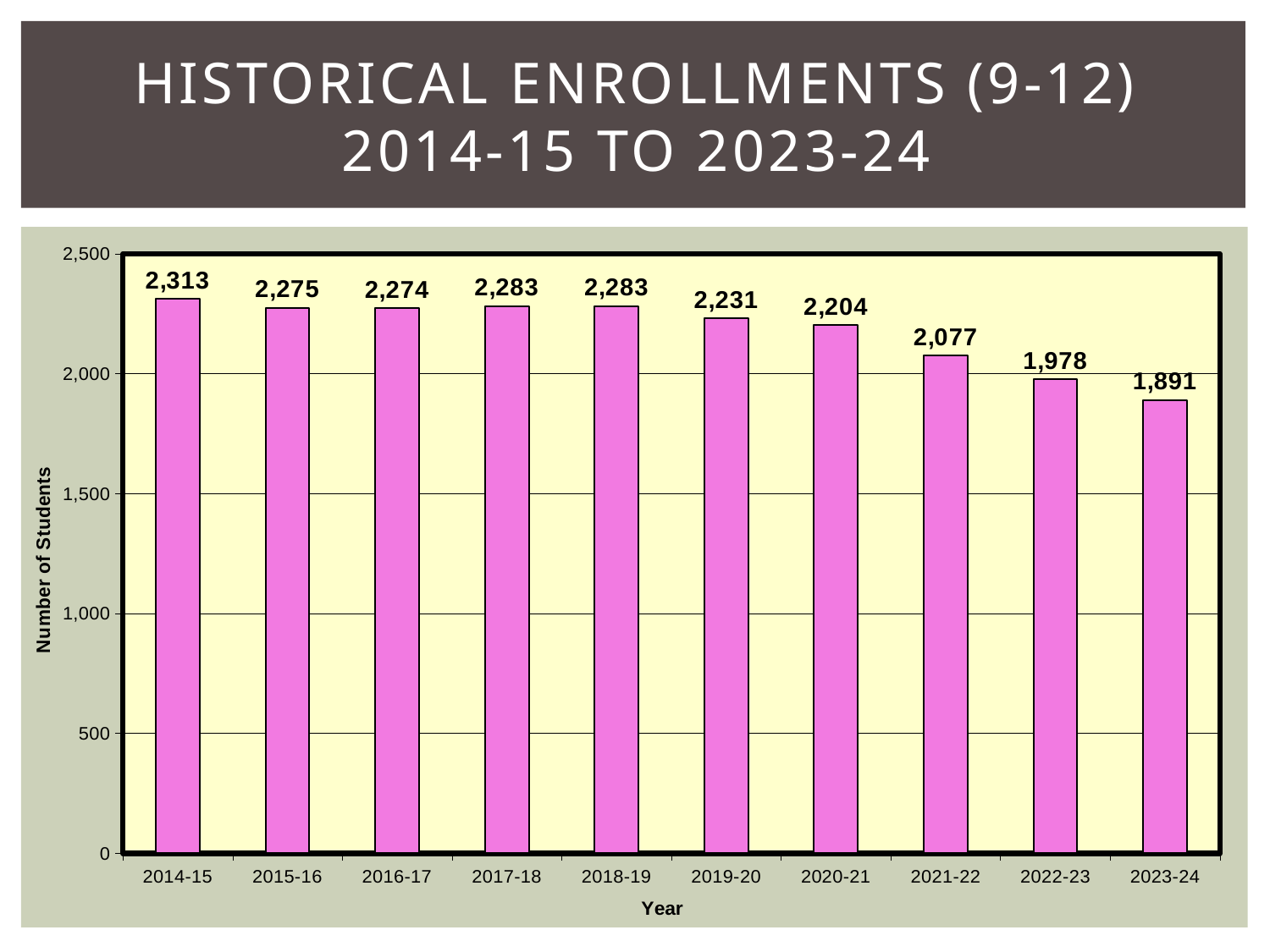
Which year has the larger enrollment, 2019-20 or 2022-23? 2019-20 Which year has the lowest enrollment? 2023-24 What is the number of students for 2014-15? 2,313 Do enrollments generally rise or fall from 2014-15 to 2023-24? fall What is the number of students for 2023-24? 1,891 What kind of chart is shown on the slide? bar chart How many years are shown on the chart? 10 What is the number of students for 2021-22? 2,077 Which year has the highest enrollment? 2014-15 Is the value for 2022-23 greater or less than 2,000? less What is the difference in enrollment between 2014-15 and 2023-24? 422 What is the difference in enrollment between 2020-21 and 2021-22? 127